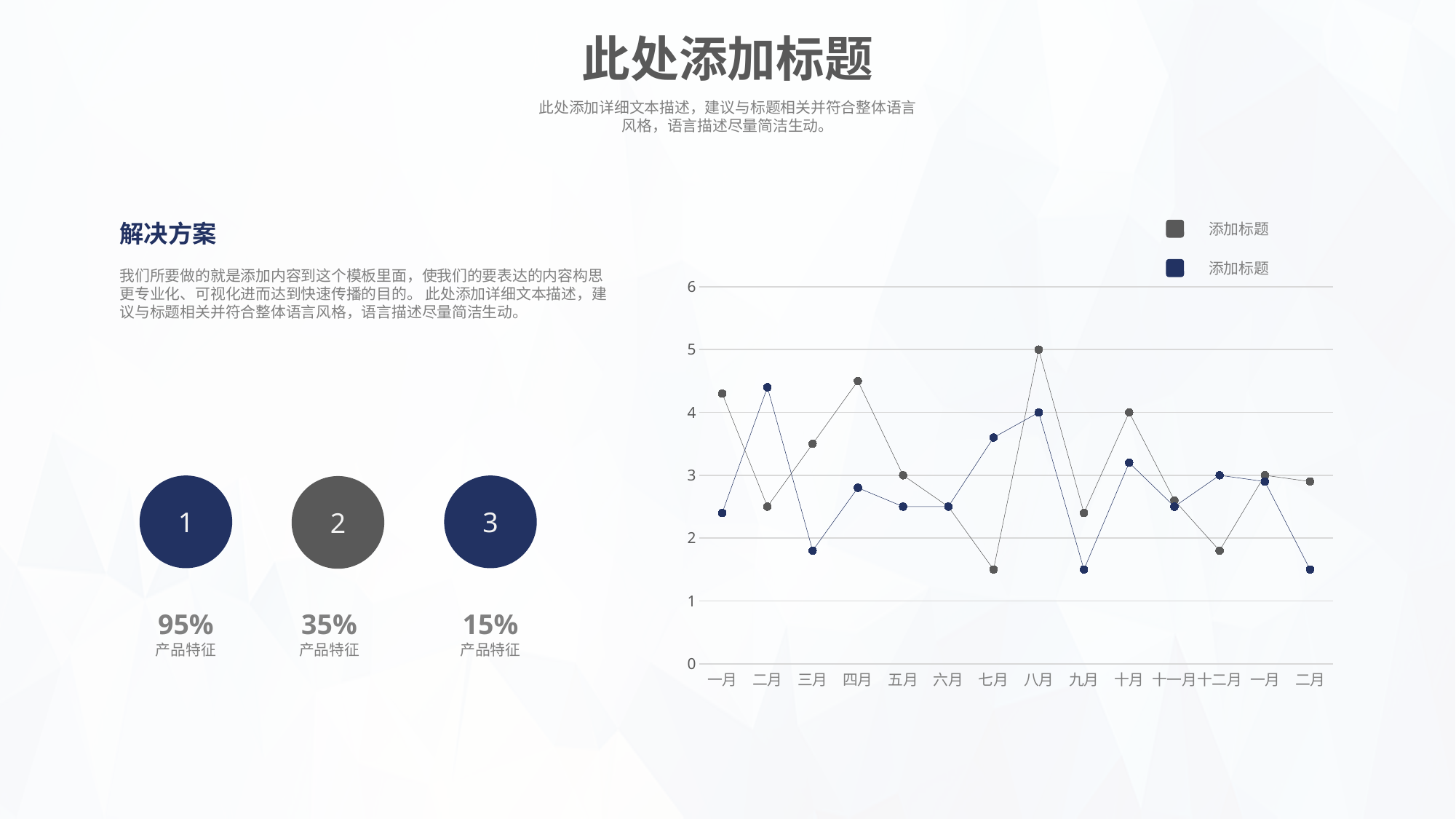
At which x-axis category does the gray series reach its lowest value? 七月 At which x-axis category does the gray series reach its highest value? 八月 What is the value of the gray series at 八月? 5 How many series does the chart legend list? 2 What is the difference between the gray series and the dark blue series at 八月? 1 What is the value of the dark blue series at 八月? 4 At 八月, which series has the larger value, the gray series or the dark blue series? gray series Is the value of the dark blue series at 九月 greater or less than 2? less How many points are plotted along the x axis for each series? 14 What kind of chart is shown on the slide? line chart What text is used for both entries in the chart legend? 添加标题 What is the value of the gray series at 十月? 4